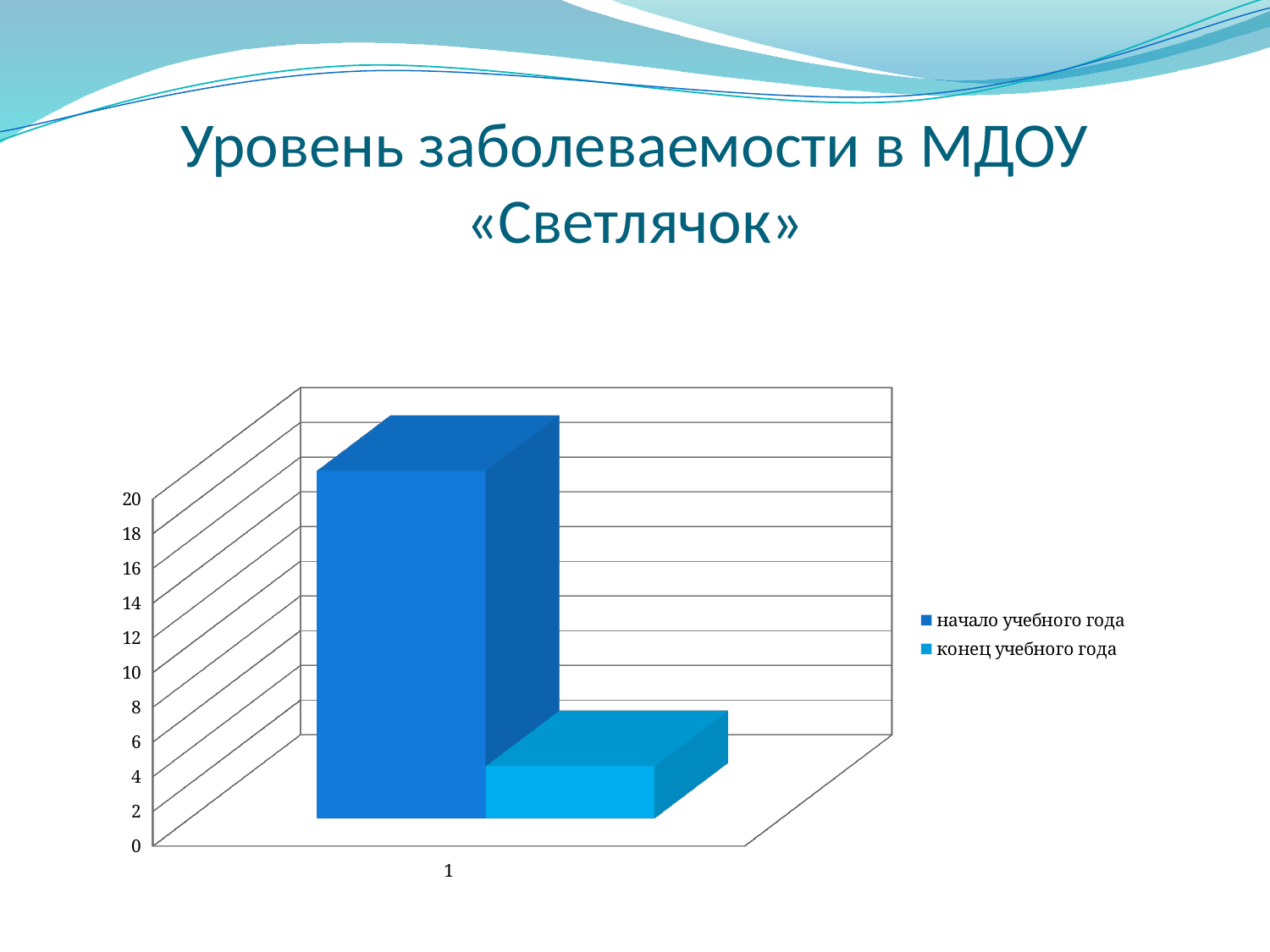
What is the maximum value shown on the vertical axis? 20 Does the illness level rise or fall from the start of the school year to the end of the school year? fall How many categories are shown on the x axis? 1 What is the title of the slide containing the chart? Уровень заболеваемости в МДОУ «Светлячок» How many series does the legend list? 2 Which series has the highest value? начало учебного года Is the value for "конец учебного года" greater or less than 8? less Which series has the lowest value? конец учебного года Is the value for "конец учебного года" greater or less than 10? less Which series has the taller bar, "начало учебного года" or "конец учебного года"? начало учебного года What kind of chart is shown on the slide? bar chart Is the value for "начало учебного года" greater or less than 10? greater